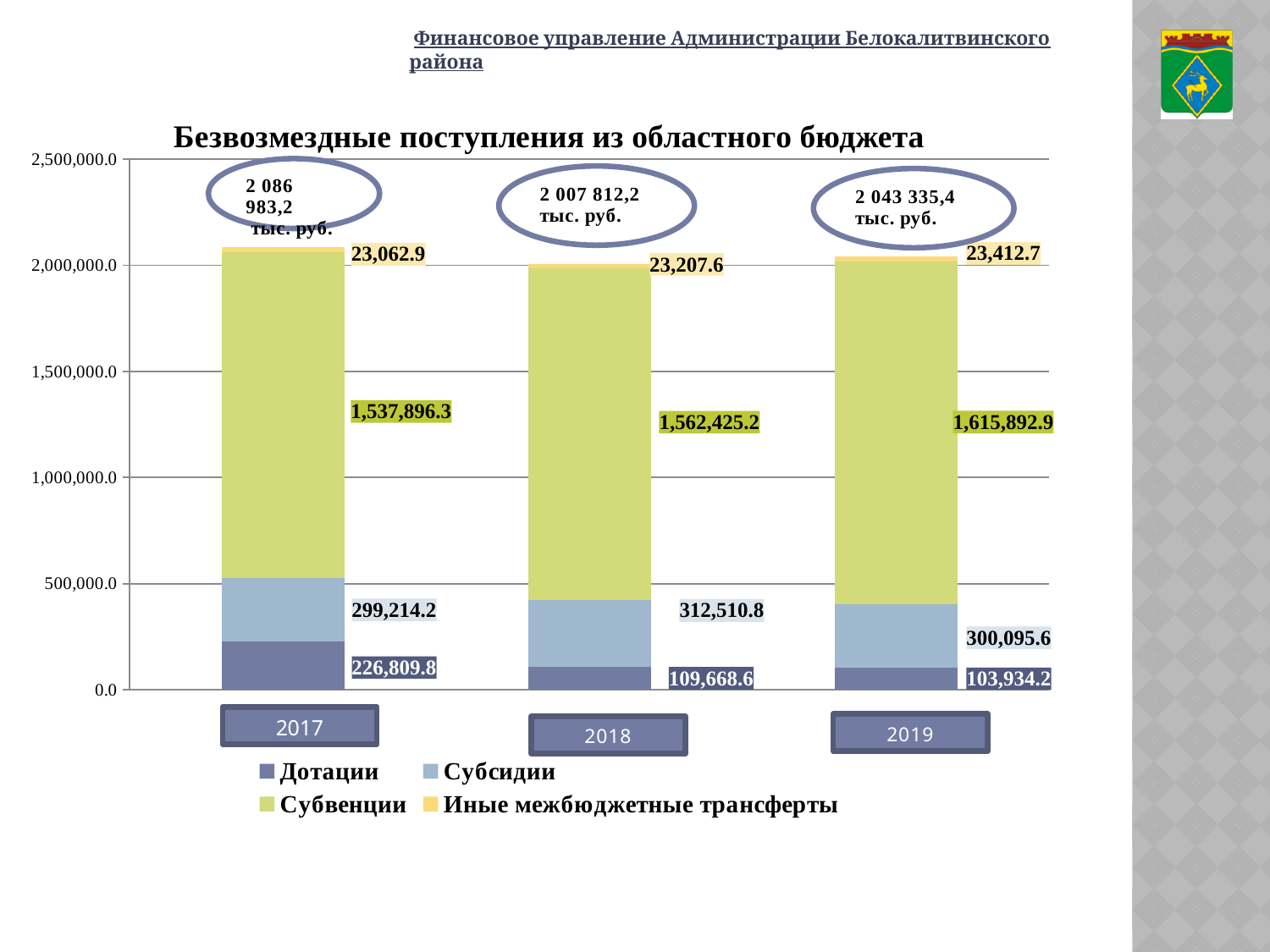
How many series does the legend list? 4 What is the value of Субвенции for 2019? 1,615,892.9 What type of chart is shown on the slide? Stacked bar chart What is the value of Субсидии for 2018? 312,510.8 What is the value of Дотации for 2017? 226,809.8 In which year is the Субвенции value the highest? 2019 In which year is the Дотации value the lowest? 2019 How many years (categories) are shown on the x axis? 3 What is the total of the stacked bar for 2018, as annotated on the slide? 2 007 812,2 тыс. руб. What is the value of Иные межбюджетные трансферты for 2017? 23,062.9 Which is larger: Субсидии in 2017 or Субсидии in 2019? Субсидии in 2019 What is the difference between the Субвенции values for 2019 and 2018? 53,467.7